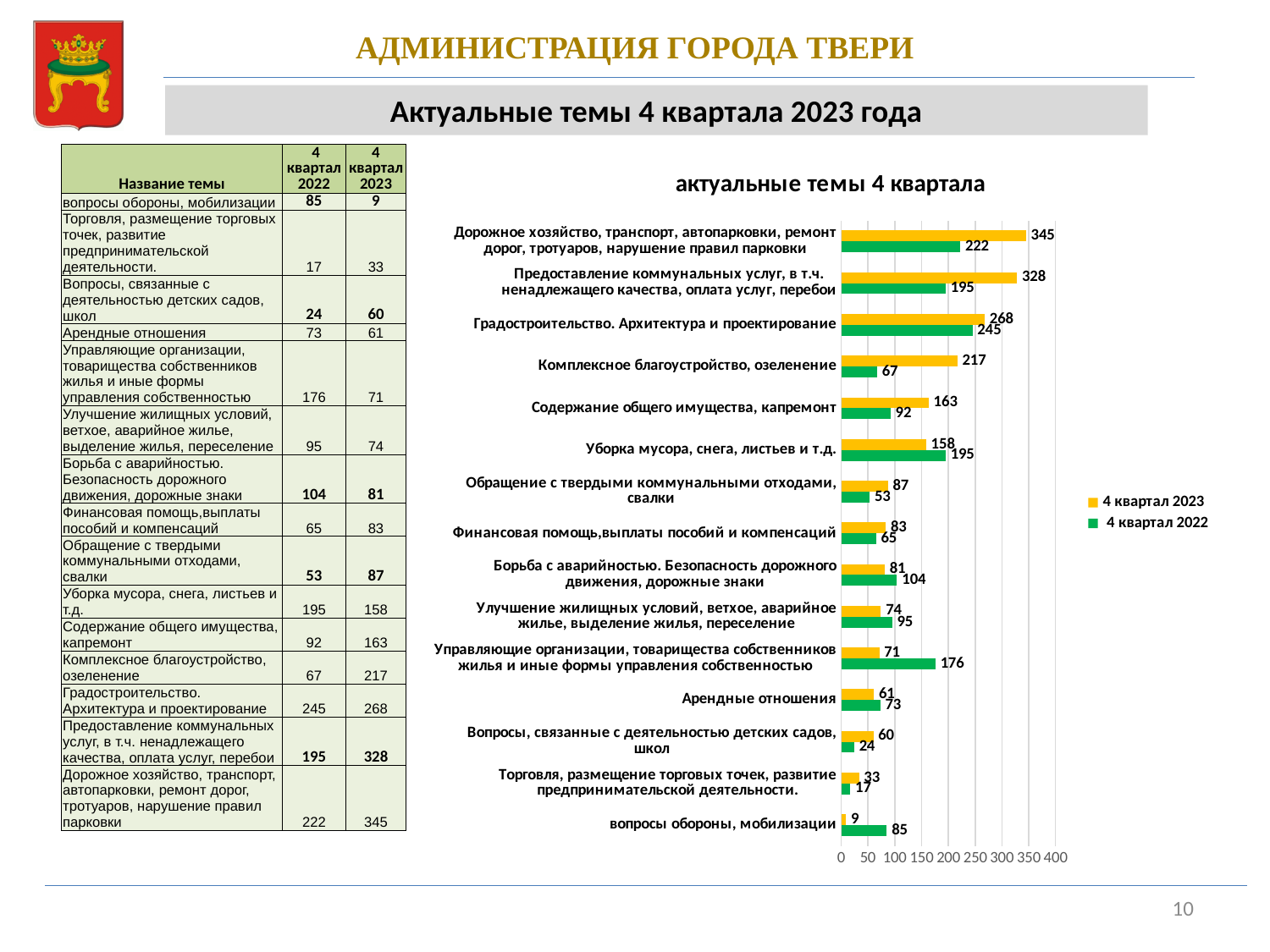
For "Управляющие организации, товарищества собственников жилья и иные формы управления собственностью", which series has the larger value: 4 квартал 2023 or 4 квартал 2022? 4 квартал 2022 Is the 4 квартал 2023 value for "Градостроительство. Архитектура и проектирование" greater or less than 250? greater How many series does the chart legend list? 2 Which category has the highest value in the 4 квартал 2023 series? Дорожное хозяйство, транспорт, автопарковки, ремонт дорог, тротуаров, нарушение правил парковки How many categories are plotted in the chart? 15 What is the value for "Уборка мусора, снега, листьев и т.д." in the 4 квартал 2022 series? 195 What type of chart is shown on the slide? bar chart What is the title of the chart? актуальные темы 4 квартала Which category has the lowest value in the 4 квартал 2023 series? вопросы обороны, мобилизации What is the difference between the 4 квартал 2023 and 4 квартал 2022 values for "Предоставление коммунальных услуг, в т.ч. ненадлежащего качества, оплата услуг, перебои"? 133 What is the value for "Комплексное благоустройство, озеленение" in the 4 квартал 2023 series? 217 Which colour represents the 4 квартал 2022 series in the chart? green